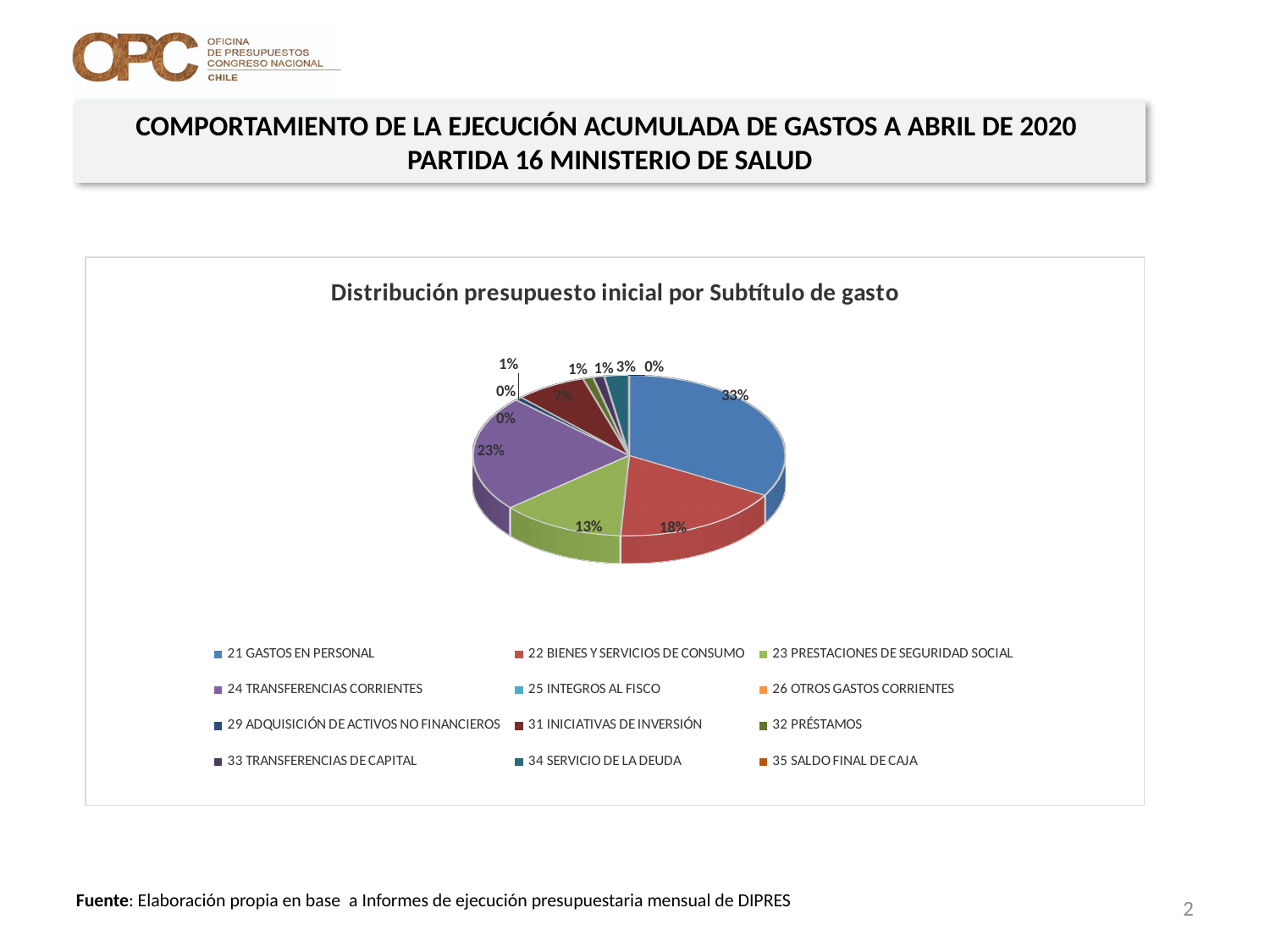
How many categories does the legend list? 12 What share of the pie does 22 BIENES Y SERVICIOS DE CONSUMO represent? 18% Which is larger, the share for 24 TRANSFERENCIAS CORRIENTES or the share for 22 BIENES Y SERVICIOS DE CONSUMO? 24 TRANSFERENCIAS CORRIENTES What share of the pie does 24 TRANSFERENCIAS CORRIENTES represent? 23% What type of chart is shown on the slide? Pie chart What share of the pie does 23 PRESTACIONES DE SEGURIDAD SOCIAL represent? 13% What is the difference in percentage points between the share for 21 GASTOS EN PERSONAL and the share for 23 PRESTACIONES DE SEGURIDAD SOCIAL? 20 Which category has the largest share of the pie? 21 GASTOS EN PERSONAL What is the title of the chart? Distribución presupuesto inicial por Subtítulo de gasto What is the combined share of 21 GASTOS EN PERSONAL and 22 BIENES Y SERVICIOS DE CONSUMO? 51%